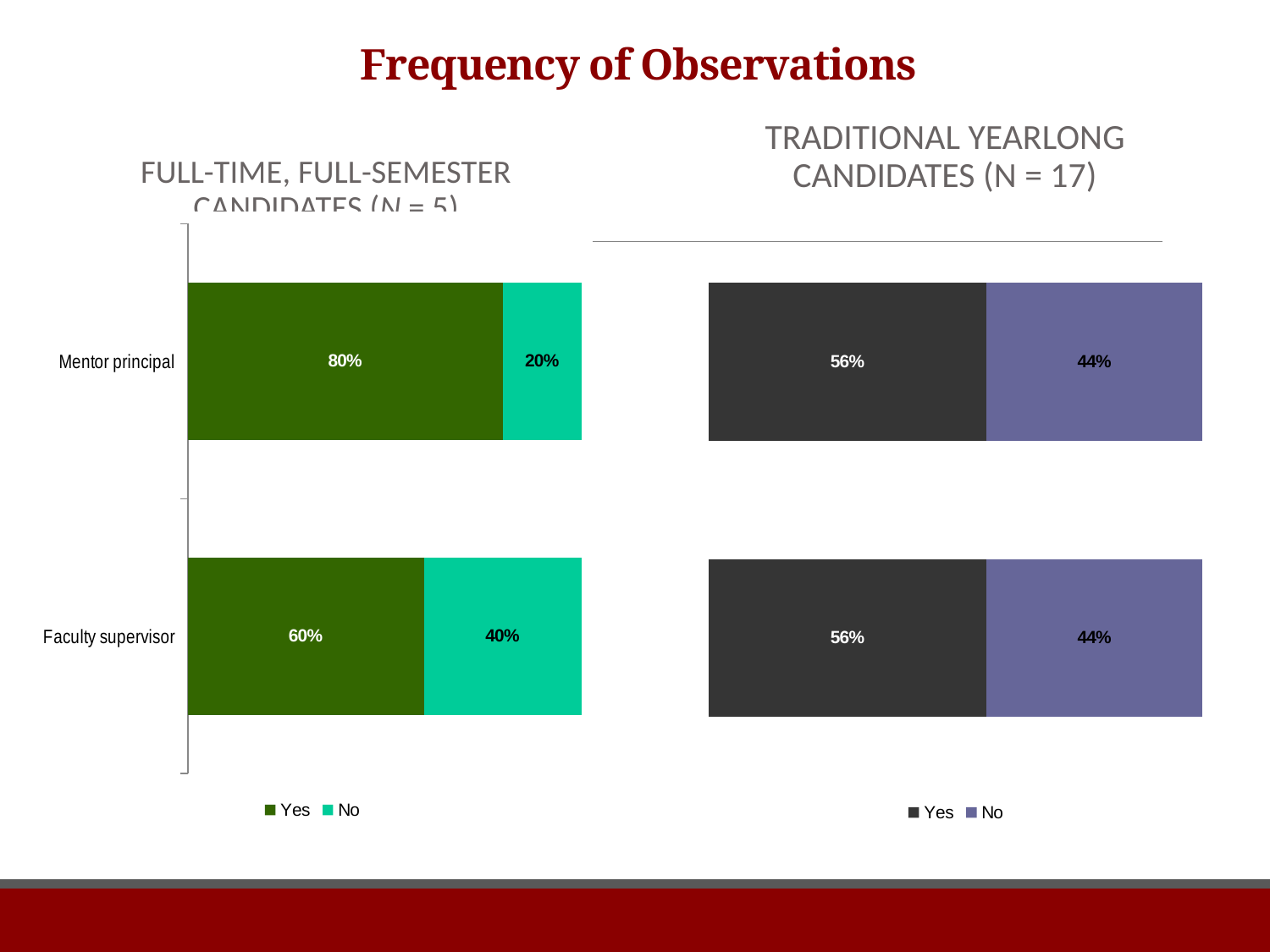
What kind of chart is the Traditional Yearlong Candidates chart? Stacked bar chart How many series does the legend of the Full-Time, Full-Semester Candidates chart list? 2 In the Full-Time, Full-Semester Candidates chart, which category has the highest Yes value? Mentor principal In the Full-Time, Full-Semester Candidates chart, what is the total of the stacked bar for Faculty supervisor? 100% In the Full-Time, Full-Semester Candidates chart, what is the Yes value for Mentor principal? 80% In the Traditional Yearlong Candidates chart, is the Yes value for Faculty supervisor larger or smaller than the No value for Faculty supervisor? larger In the Traditional Yearlong Candidates chart, what is the No value for Faculty supervisor? 44% In the Traditional Yearlong Candidates chart, what is the Yes value for Mentor principal? 56% In the Full-Time, Full-Semester Candidates chart, what is the difference between the Yes values for Mentor principal and Faculty supervisor? 20% How many categories are shown in the Traditional Yearlong Candidates chart? 2 In the Full-Time, Full-Semester Candidates chart, what is the No value for Faculty supervisor? 40% In the Full-Time, Full-Semester Candidates chart, which category has the lowest No value? Mentor principal